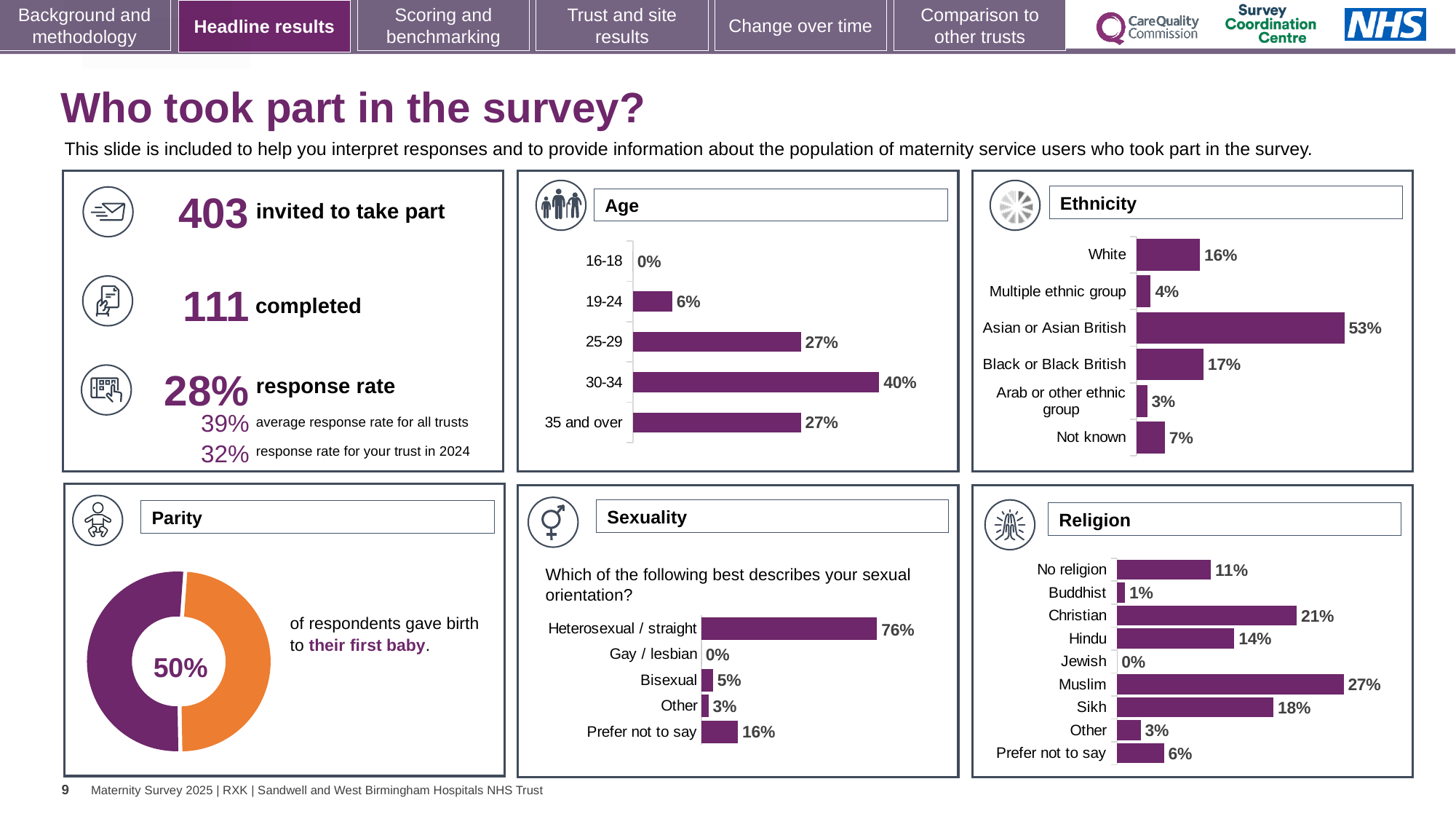
In the Religion chart, what is the difference between the Christian and Sikh percentages? 3% What kind of chart is the Parity chart? Doughnut chart In the Ethnicity chart, which category has the lowest percentage? Arab or other ethnic group In the Sexuality chart, which is larger, Bisexual or Other? Bisexual In the Age chart, which age group has the highest percentage? 30-34 In the Age chart, how many age categories are shown? 5 In the Age chart, what percentage of respondents were aged 30-34? 40% In the Ethnicity chart, what percentage of respondents were Asian or Asian British? 53% In the Sexuality chart, what percentage of respondents answered Prefer not to say? 16% In the Parity chart, what percentage of respondents gave birth to their first baby? 50% In the Ethnicity chart, what is the difference between the White and Black or Black British percentages? 1% In the Religion chart, which religion has the highest percentage? Muslim